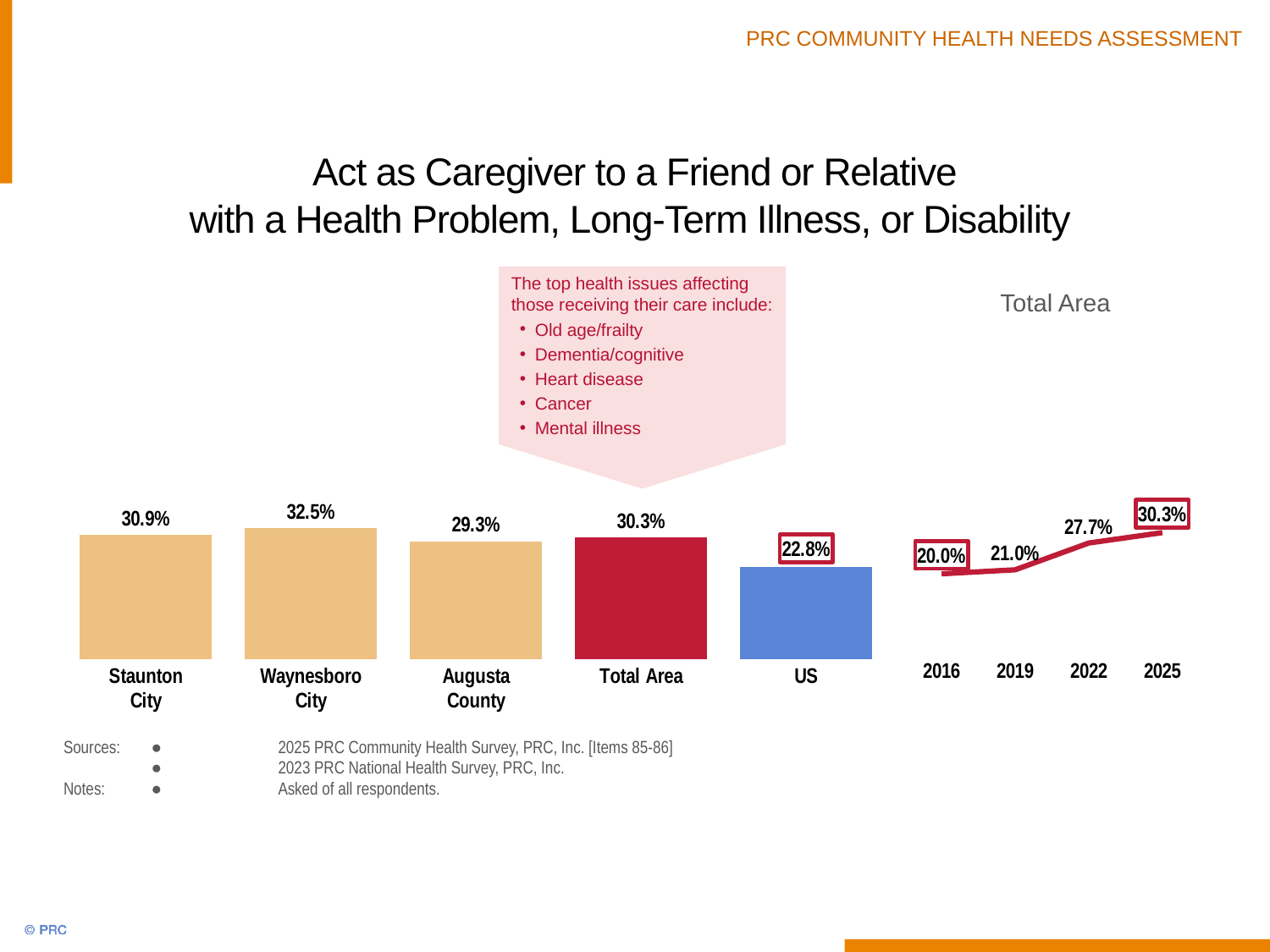
In the bar chart on the left, what is the value for Waynesboro City? 32.5% In the Total Area line chart on the right, what is the value for 2019? 21.0% In the bar chart on the left, what is the difference between the Total Area value and the US value? 7.5 percentage points In the bar chart on the left, which category has the highest value? Waynesboro City In the bar chart on the left, what is the value for the US? 22.8% What kind of chart is the chart on the left of the slide? Bar chart In the bar chart on the left, which category has the lowest value? US How many data points are plotted in the Total Area line chart on the right? 4 In the Total Area line chart on the right, what is the difference between the 2025 value and the 2016 value? 10.3 percentage points How many categories are shown in the bar chart on the left? 5 In the Total Area line chart on the right, do the values rise or fall from 2016 to 2025? Rise In the bar chart on the left, which is larger: Staunton City or Augusta County? Staunton City